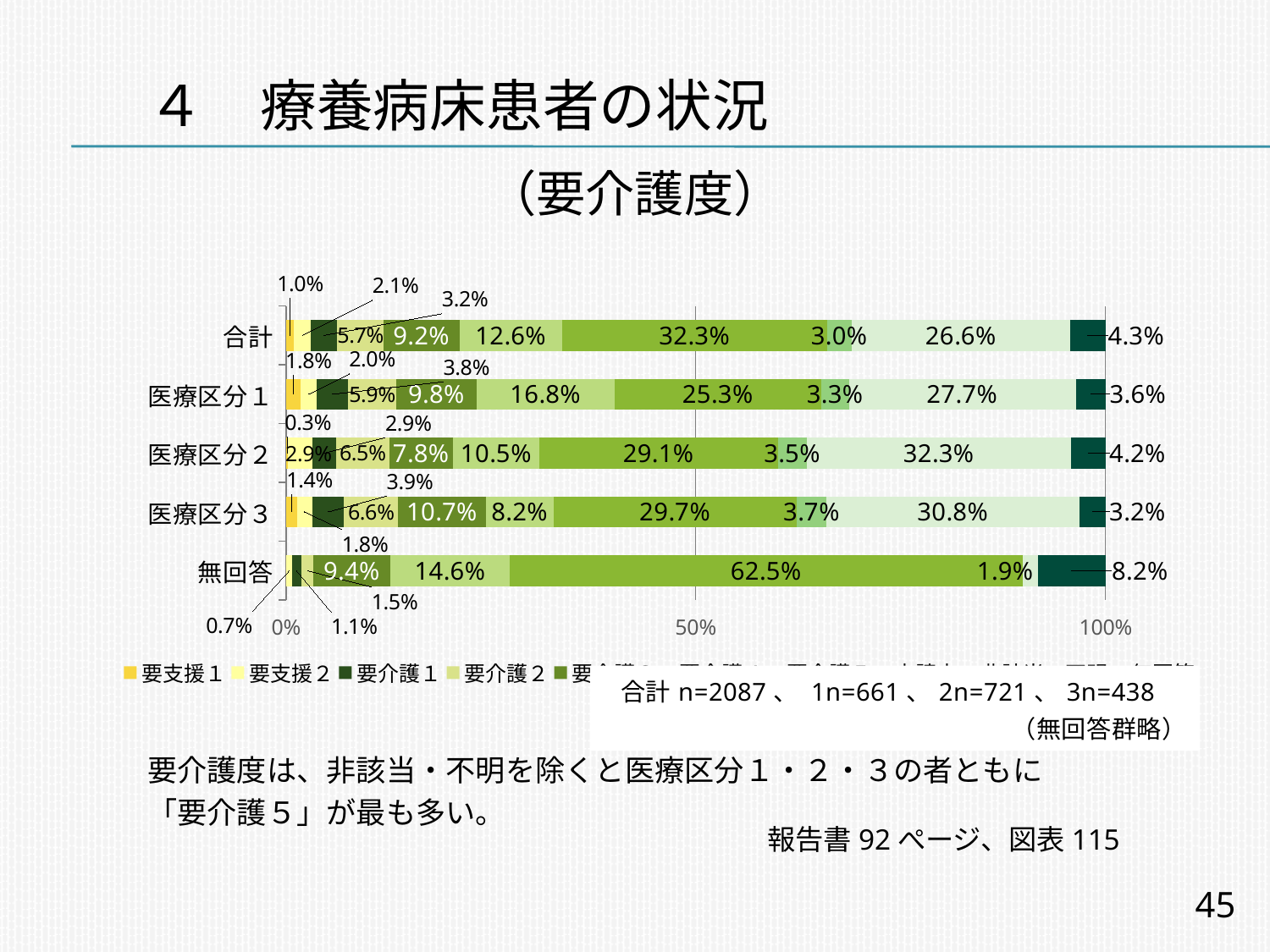
What is the value of 要介護２ for 合計? 5.7% What is the title shown above the chart? （要介護度） Which has the larger 要介護２ value, 合計 or 医療区分１? 医療区分１ What is the value of 要支援１ for 合計? 1.0% What is the value of 要支援１ for 医療区分１? 1.8% How many category bars does the chart have? 5 What is the value of 要介護１ for 医療区分１? 3.8% What is the largest segment value in the 合計 bar? 32.3% What kind of chart is shown on the slide? bar chart What is the value of the rightmost (dark green) segment of the 無回答 bar? 8.2% What is the difference between the 要介護１ values for 医療区分１ and 合計? 0.6% What is the largest segment value in the 無回答 bar? 62.5%